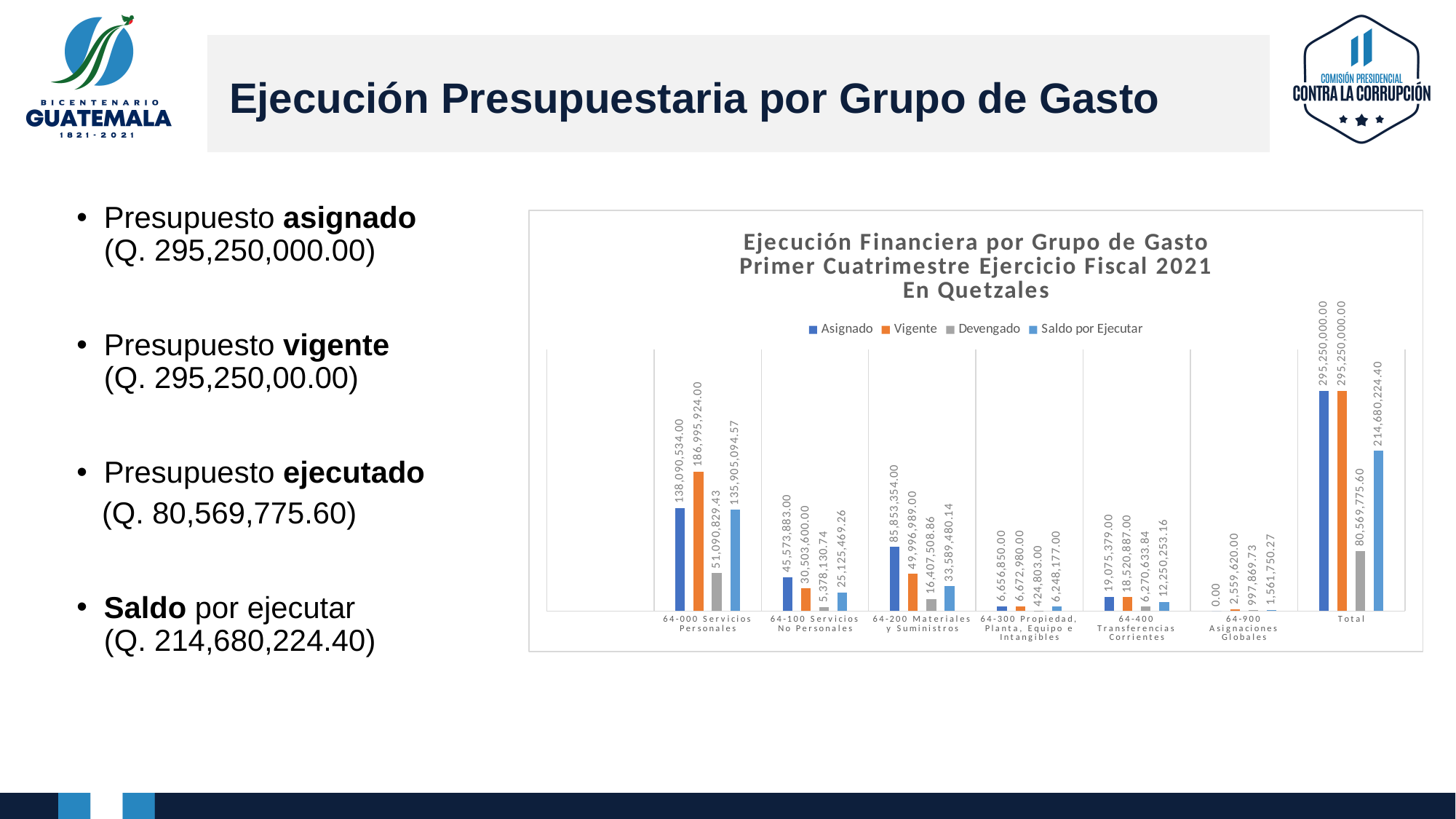
What is the title of the chart? Ejecución Financiera por Grupo de Gasto Primer Cuatrimestre Ejercicio Fiscal 2021 En Quetzales How many categories are shown along the x axis of the chart? 7 What is the Vigente value for 64-000 Servicios Personales? 186,995,924.00 Excluding the Total category, which expense group has the highest Devengado value? 64-000 Servicios Personales What is the Devengado value for 64-200 Materiales y Suministros? 16,407,508.86 What is the Saldo por Ejecutar value for 64-400 Transferencias Corrientes? 12,250,253.16 Which is larger for 64-100 Servicios No Personales: the Asignado value or the Vigente value? Asignado What is the Asignado value for 64-900 Asignaciones Globales? 0.00 What is the difference between the Vigente and Devengado values for the Total category? 214,680,224.40 Excluding the Total category, which expense group has the lowest Asignado value? 64-900 Asignaciones Globales How many series does the chart legend list? 4 What type of chart is shown on the slide? bar chart